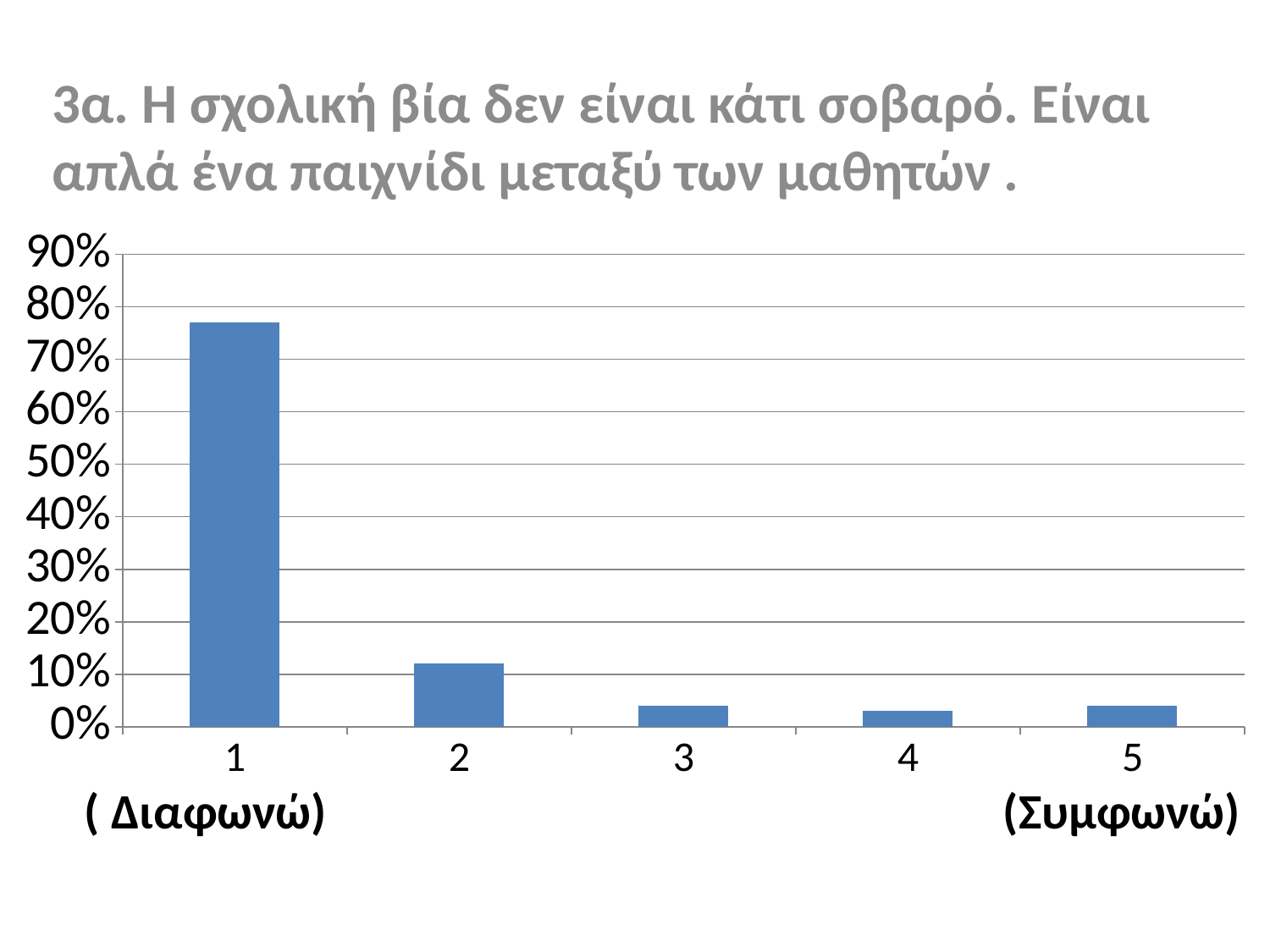
Is the value for category 2 greater or less than 20%? less Is the value for category 3 greater or less than 10%? less What kind of chart is shown on the slide? bar chart Is the value for category 1 greater or less than 80%? less What label appears under category 1 on the x axis? ( Διαφωνώ) How many categories are shown on the x axis of the chart? 5 Which is larger, the value for category 2 or the value for category 3? category 2 Do the values rise or fall from category 1 to category 3? fall Which category has the highest bar in the chart? 1 Which is larger, the value for category 1 or the value for category 2? category 1